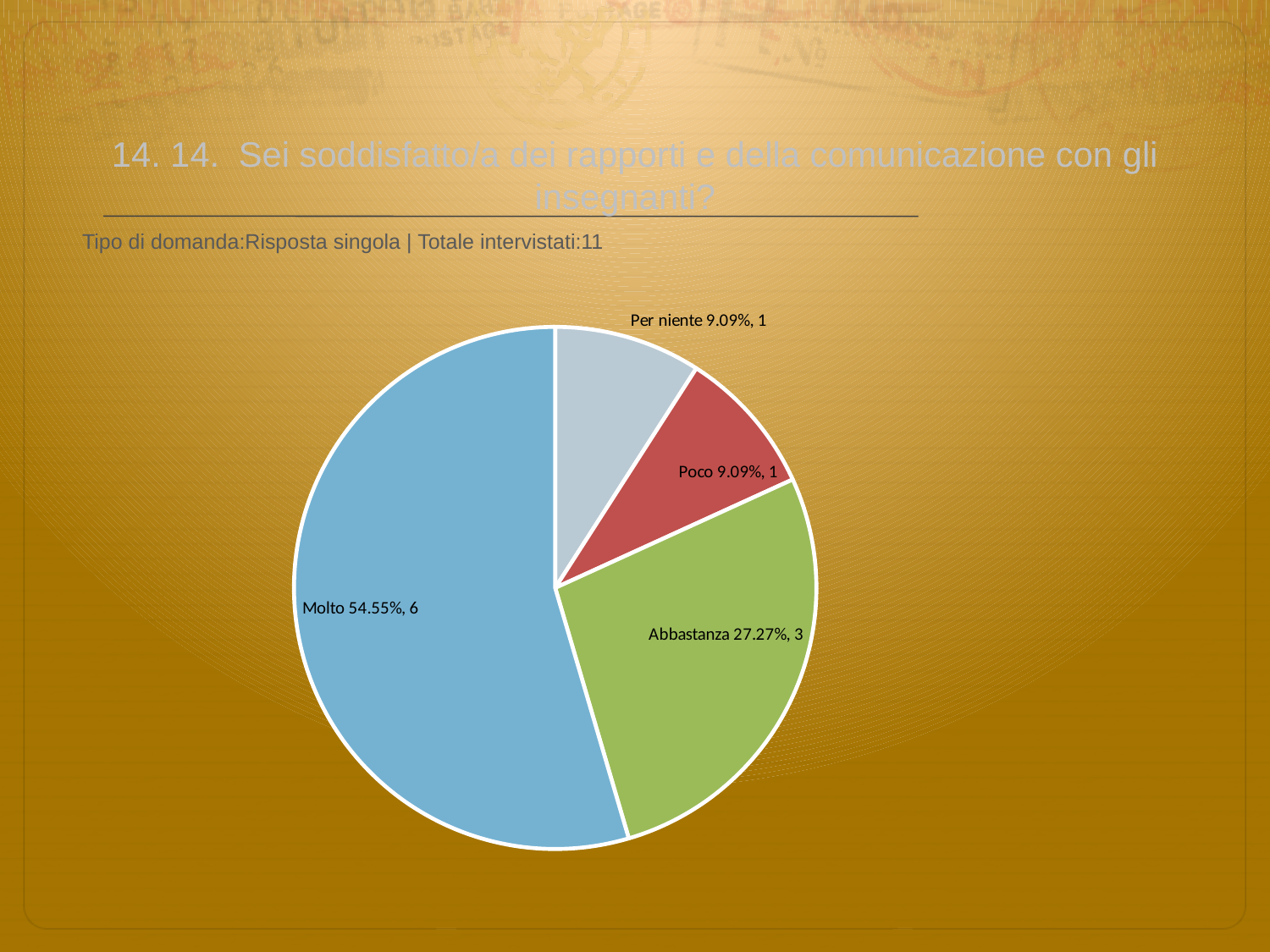
How many respondents answered "Abbastanza"? 3 What colour is the "Molto" slice? blue What percentage share does the "Per niente" slice have? 9.09% Which is larger, the "Abbastanza" slice or the "Poco" slice? Abbastanza What is the difference in number of respondents between "Molto" and "Abbastanza"? 3 How many respondents answered "Poco"? 1 How many slices does the pie chart have? 4 What percentage share does the "Molto" slice have? 54.55% What is the total number of respondents across all slices of the pie? 11 What kind of chart is shown on the slide? pie chart Which category has the largest slice of the pie? Molto What percentage share does the "Abbastanza" slice have? 27.27%